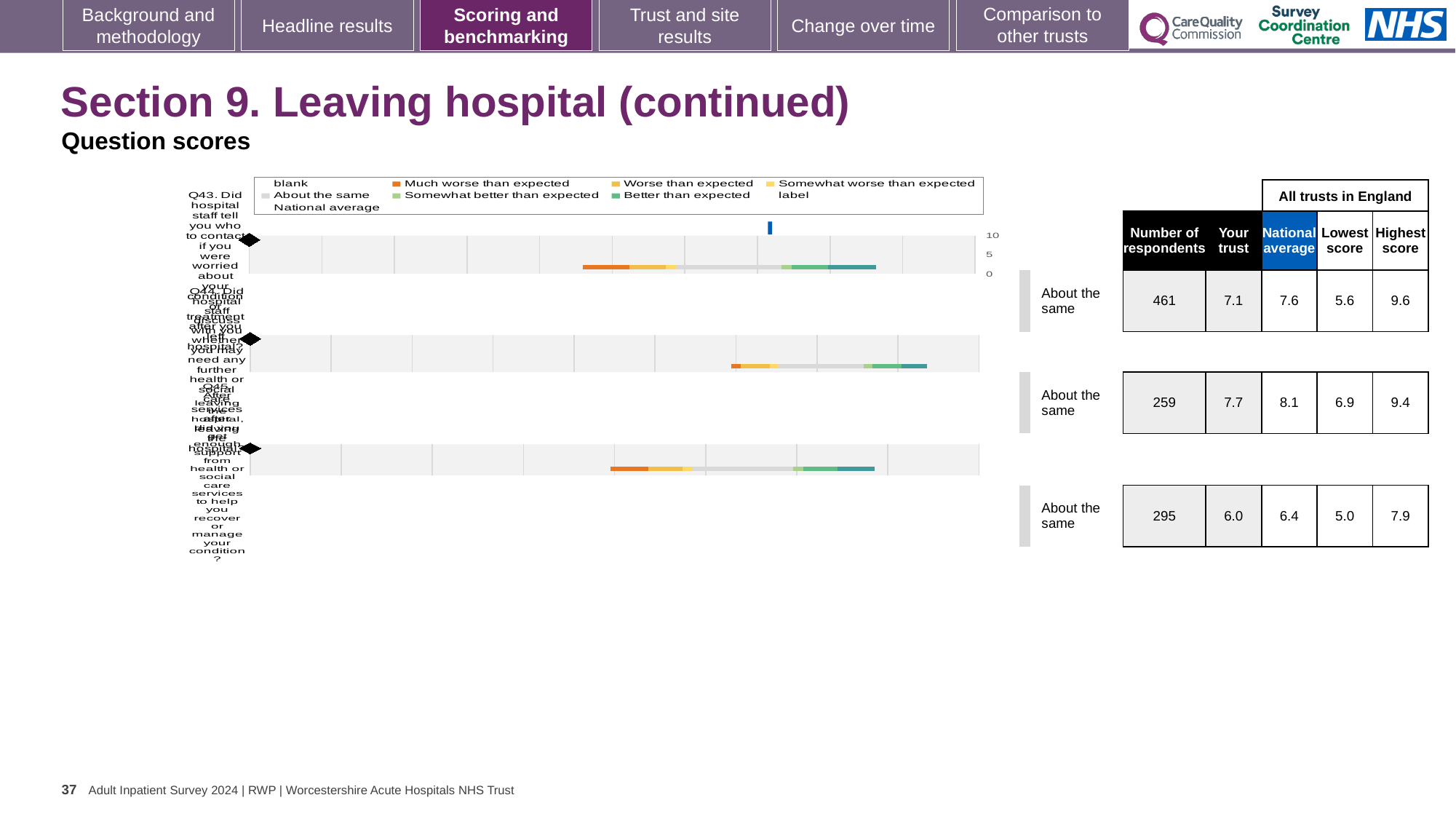
What is the lowest score across all trusts in England for the third (bottom) question row? 5.0 What is the highest score across all trusts in England for the first (top) question row? 9.6 In the table next to the charts, how many respondents are listed for the first (top) question row? 461 Which of the three question rows has the highest 'Your trust' score? The second (middle) row, 7.7 What is the 'Your trust' score shown for the first (top) question row? 7.1 For the first (top) question row, is the 'Your trust' score higher or lower than the national average? Lower What benchmark category is shown beside each of the three question rows? About the same What kind of chart is used to show the question scores on this slide? Bar chart What is the national average shown for the first (top) question row? 7.6 For the third (bottom) question row, what is the difference between the national average and the 'Your trust' score? 0.4 How many respondents are listed for the second (middle) question row? 259 Which of the three question rows has the lowest 'Your trust' score? The third (bottom) row, 6.0